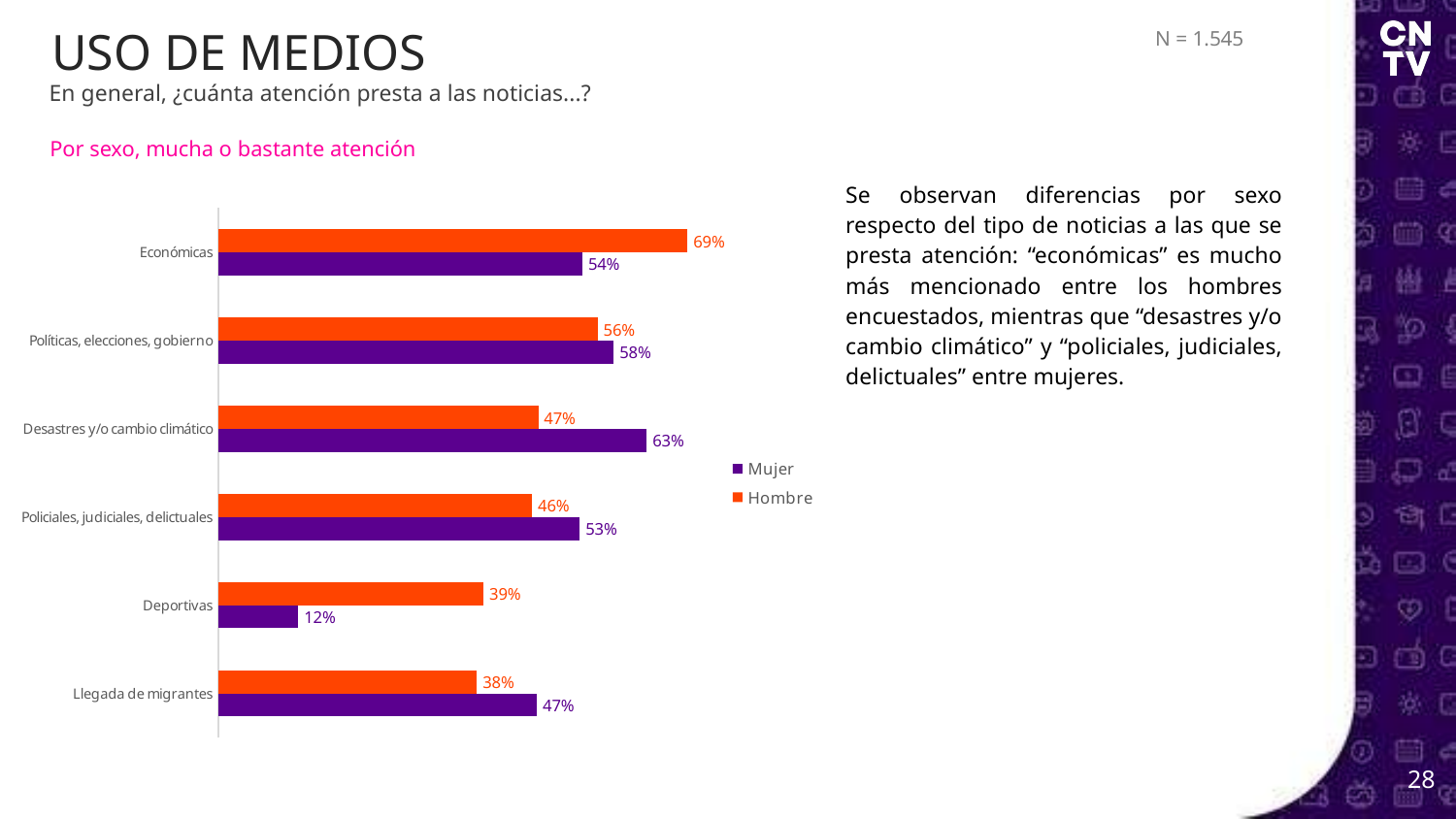
Which category has the highest value for the Hombre series? Económicas How many news categories are shown on the chart? 6 What is the value for Mujer in the Desastres y/o cambio climático category? 63% How many series does the legend list? 2 Which colour represents the Hombre series in the chart? Orange What percentage of men (Hombre) pay much or quite a lot of attention to economic news (Económicas)? 69% What is the difference between the Hombre and Mujer values for Deportivas? 27 percentage points What kind of chart is shown on the slide? Bar chart What is the value for Mujer in the Deportivas category? 12% Which category has the lowest value for the Mujer series? Deportivas For Policiales, judiciales, delictuales, which series has the larger value, Mujer or Hombre? Mujer What is the difference between the Mujer and Hombre values for Desastres y/o cambio climático? 16 percentage points